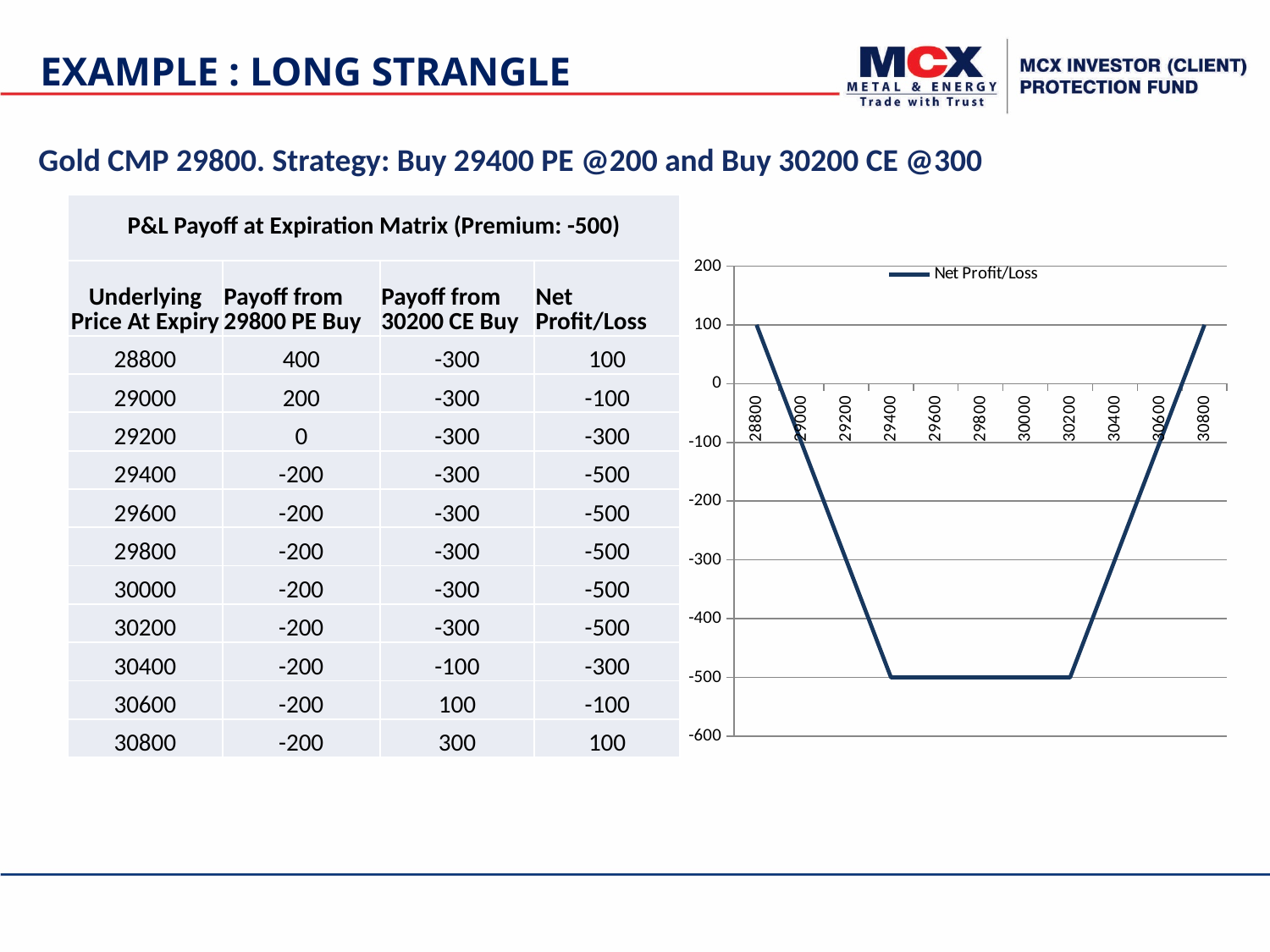
What is the Net Profit/Loss value at an underlying price of 29200? -300 Is the Net Profit/Loss at an underlying price of 30400 greater or less than -200? less Which has the higher Net Profit/Loss: an underlying price of 29000 or 29800? 29000 How many series does the chart legend list? 1 What is the lowest Net Profit/Loss value shown in the chart? -500 What is the Net Profit/Loss value at an underlying price of 28800? 100 What is the name of the series plotted in the chart? Net Profit/Loss What is the Net Profit/Loss value at an underlying price of 29400? -500 What kind of chart is shown on the slide? line chart What is the difference between the Net Profit/Loss at 30800 and at 30200? 600 Does the Net Profit/Loss rise or fall as the underlying price moves from 28800 to 29400? fall How many underlying price points are plotted along the x axis of the chart? 11